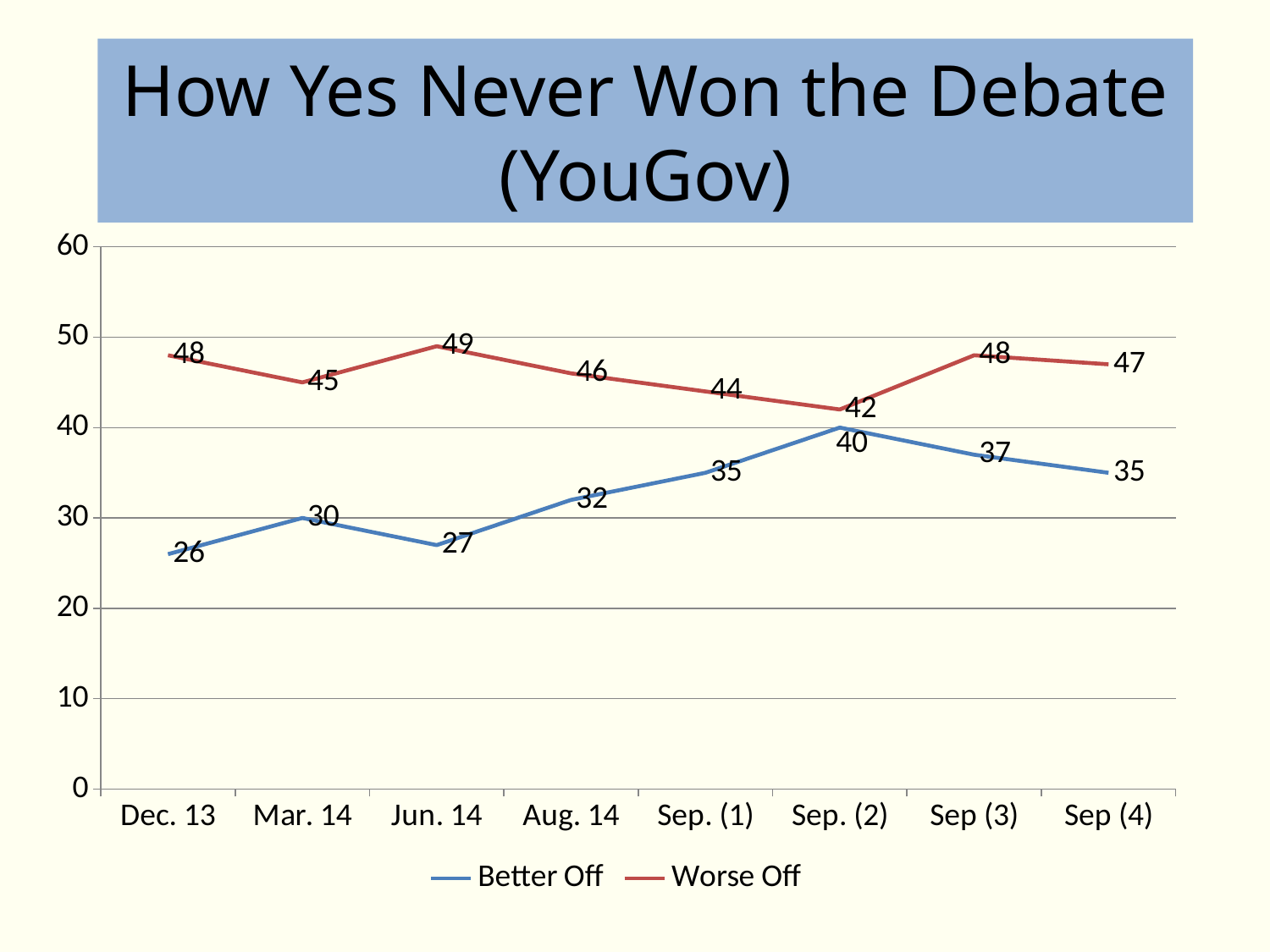
Which is larger at Aug. 14, Better Off or Worse Off? Worse Off What kind of chart is shown? Line chart How many series does the legend list? 2 What is the title of the chart? How Yes Never Won the Debate (YouGov) What is the value for Worse Off at Jun. 14? 49 Does the Better Off series rise or fall from Jun. 14 to Sep. (2)? Rise At which point is the Better Off series lowest? Dec. 13 What is the value for Better Off at Dec. 13? 26 How many points are plotted along the x axis? 8 At which point is the Worse Off series highest? Jun. 14 What is the value for Better Off at Sep. (2)? 40 What is the difference between Worse Off and Better Off at Sep. (2)? 2